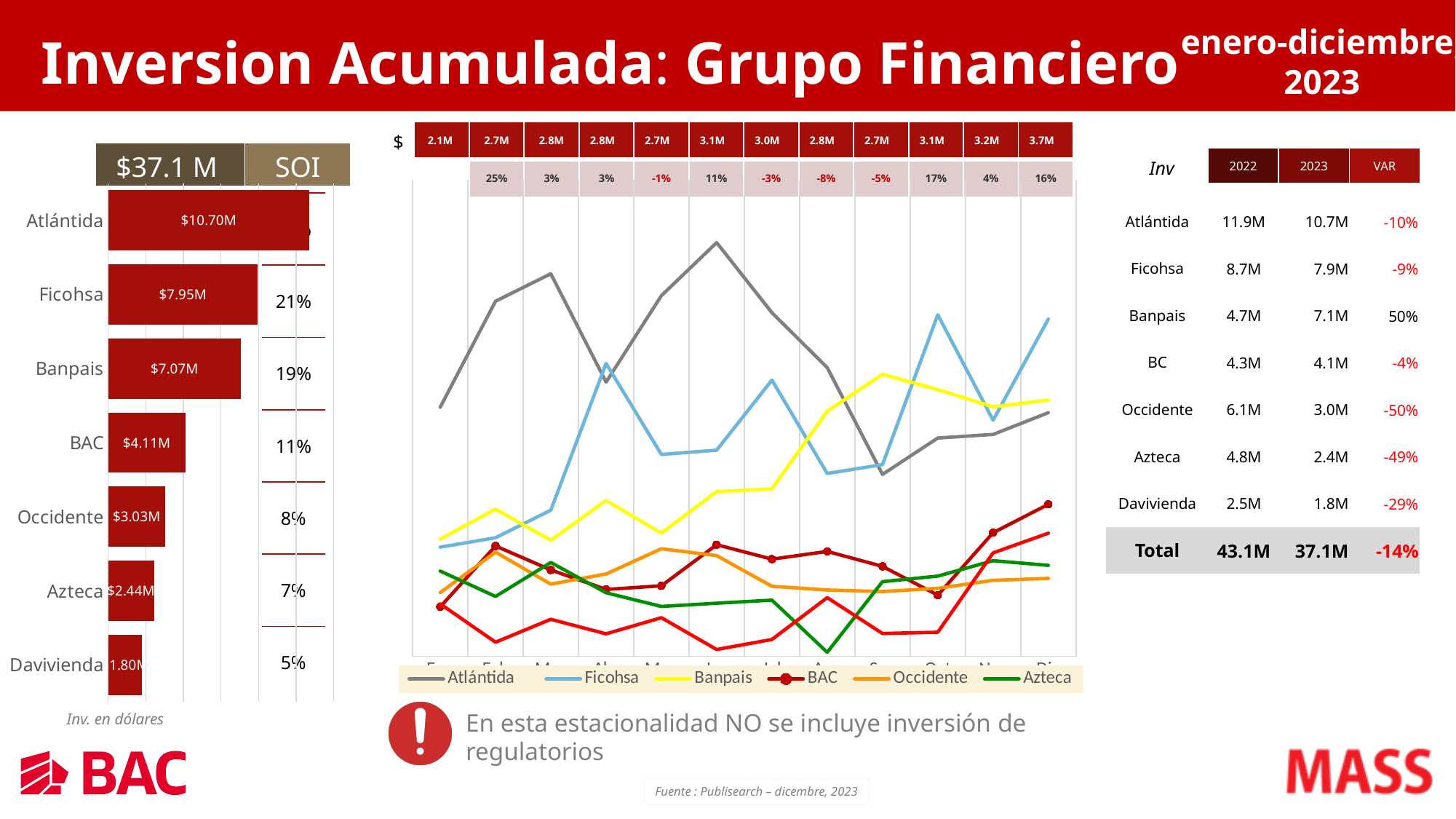
What kind of chart is the chart in the middle of the slide? Line chart In the bar chart on the left, which is larger: the value for Occidente or the value for Azteca? Occidente What kind of chart is the chart on the left of the slide? Bar chart In the bar chart on the left, what is the value for BAC? $4.11M In the bar chart on the left, which bank has the highest accumulated investment? Atlántida How many banks are shown in the bar chart on the left? 7 In the bar chart on the left, which bank has the lowest accumulated investment? Davivienda How many series does the legend of the line chart in the middle list? 6 In the bar chart on the left, what is the difference between the values for Ficohsa and Banpais? $0.88M In the line chart in the middle, which series has the highest value in Dic? Ficohsa In the bar chart on the left, what is the value for Atlántida? $10.70M In the line chart in the middle, which series has the lowest value in Ago? Azteca